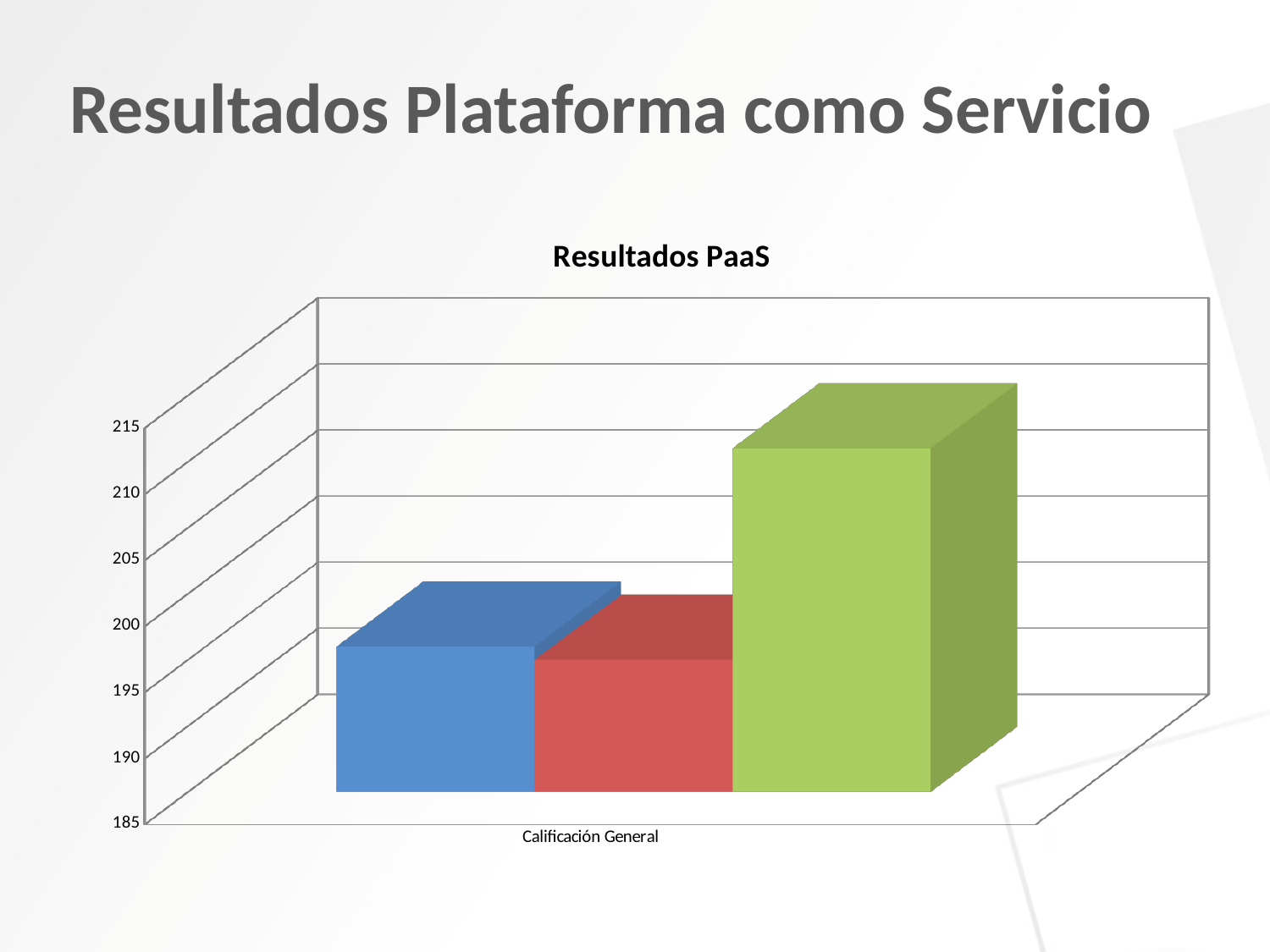
Which bar is the highest in the chart? the green bar What is the highest value shown on the vertical axis? 215 What is the title of the chart? Resultados PaaS Which is larger, the value of the green bar or the value of the blue bar? the green bar Is the value of the green bar greater or less than 205? greater How many bars are plotted in the chart? 3 Is the value of the red bar greater or less than 200? less What kind of chart is shown on the slide? bar chart What is the label of the category shown on the x axis? Calificación General Is the value of the blue bar greater or less than 200? less